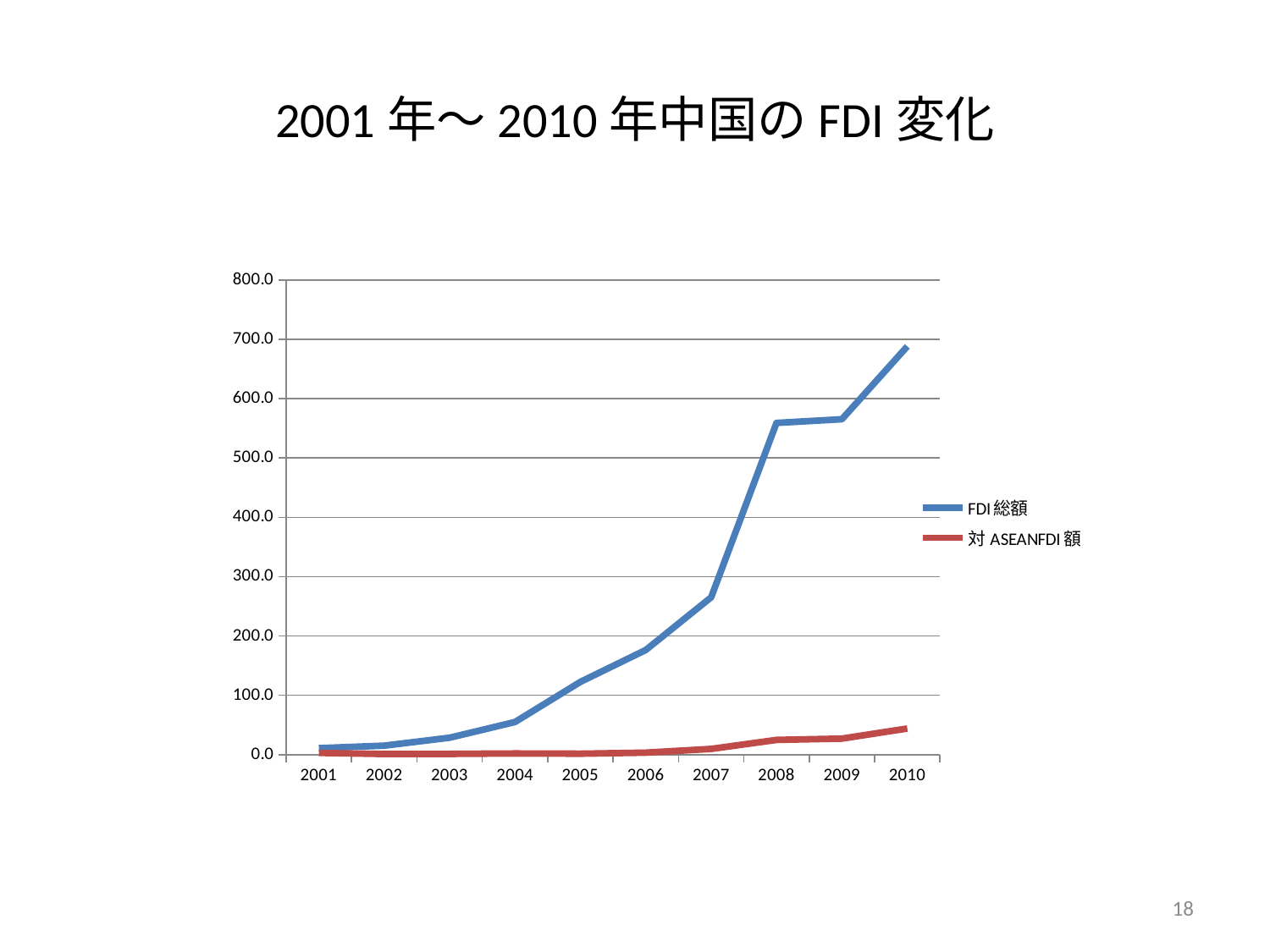
How many series does the legend list? 2 How many years are plotted along the x axis? 10 Does the FDI総額 series generally rise or fall from 2001 to 2010? Rise Is the value of FDI総額 in 2010 greater or less than 600.0? greater In which year is the FDI総額 series at its lowest? 2001 Is the value of FDI総額 in 2008 greater or less than 500.0? greater In which year is the FDI総額 series at its highest? 2010 Which colour is used for the 対ASEANFDI額 series? Red In 2010, which series has the larger value, FDI総額 or 対ASEANFDI額? FDI総額 Is the value of 対ASEANFDI額 in 2010 greater or less than 100.0? less What kind of chart is shown on the slide? Line chart